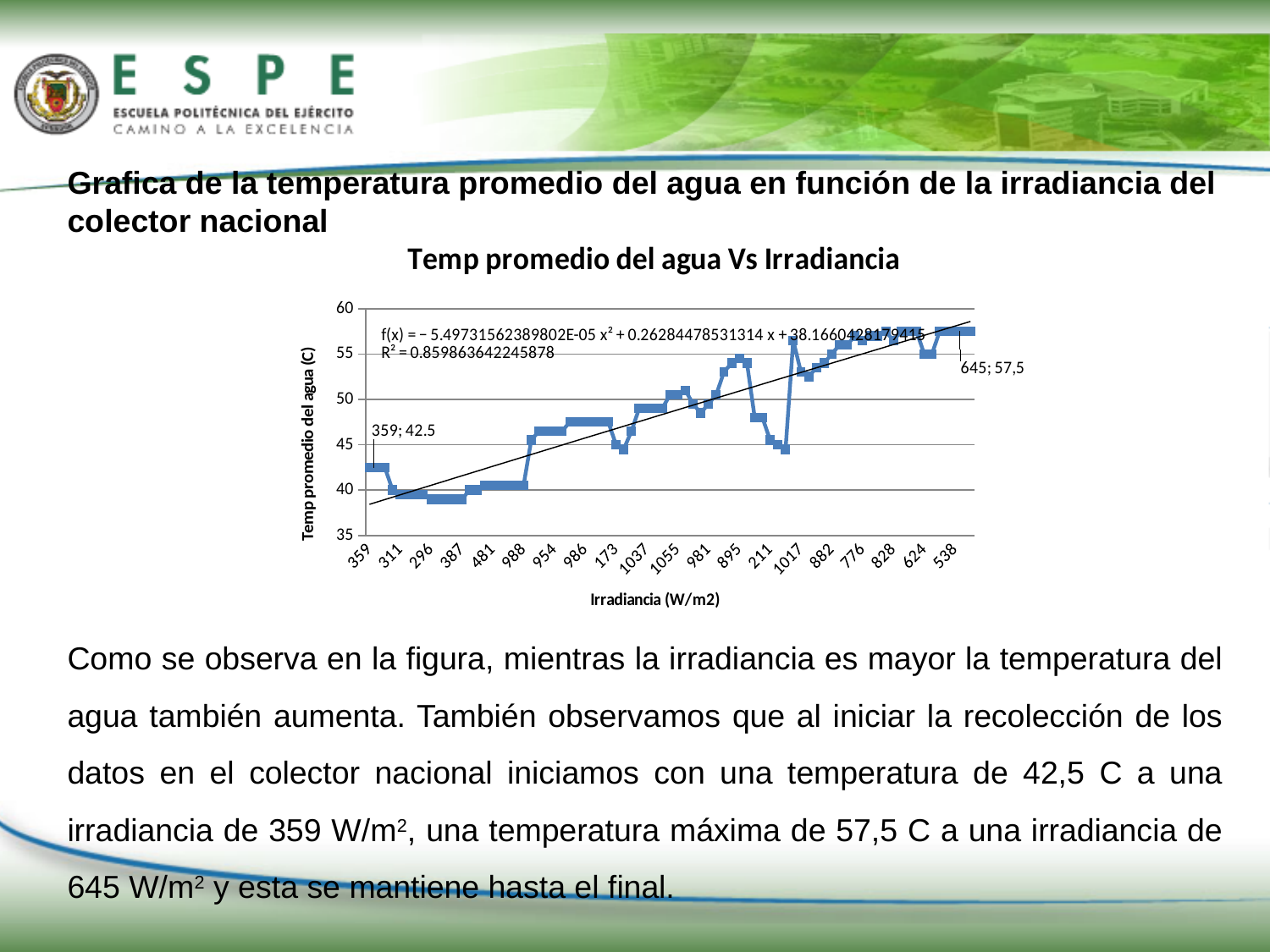
Is the temperature at the x-axis label 481 greater or less than 45? less Which labelled point has the higher temperature, the one at 359 W/m2 or the one at 645 W/m2? 645 W/m2 Is the temperature at the x-axis label 776 greater or less than 50? greater Is the temperature at the x-axis label 1037 greater or less than 45? greater What is the average water temperature at the labelled point at an irradiance of 645 W/m2? 57,5 What is the average water temperature at the first data point, at an irradiance of 359 W/m2? 42.5 What is the difference between the labelled temperature at 645 W/m2 and the labelled temperature at 359 W/m2? 15 What kind of chart is shown on the slide? line chart What is the title of the chart? Temp promedio del agua Vs Irradiancia What R² value is printed for the trendline on the chart? 0.859863642245878 Does the water temperature generally rise or fall as you move along the x axis? rise At which labelled irradiance does the water temperature reach its maximum? 645